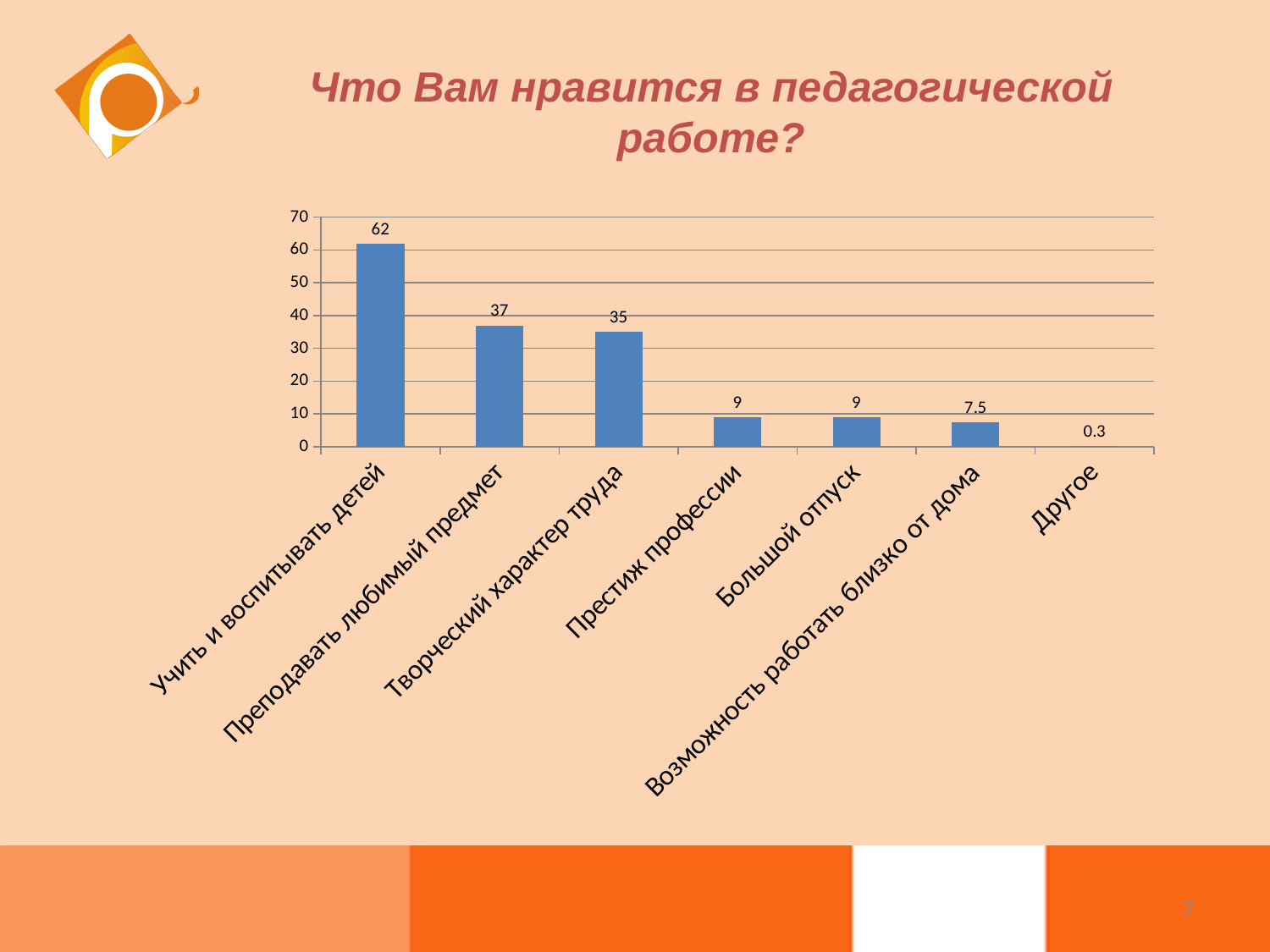
Is the value for "Творческий характер труда" greater or less than 30? greater What kind of chart is shown on the slide? bar chart How many categories are shown on the x axis? 7 What is the value for "Преподавать любимый предмет"? 37 Which category has the lowest value? Другое What is the value for "Другое"? 0.3 Which is larger: the value for "Творческий характер труда" or the value for "Престиж профессии"? Творческий характер труда What is the title of the slide above the chart? Что Вам нравится в педагогической работе? What is the difference between the values for "Учить и воспитывать детей" and "Преподавать любимый предмет"? 25 Which category has the highest value? Учить и воспитывать детей What is the value for "Учить и воспитывать детей"? 62 What is the value for "Возможность работать близко от дома"? 7.5